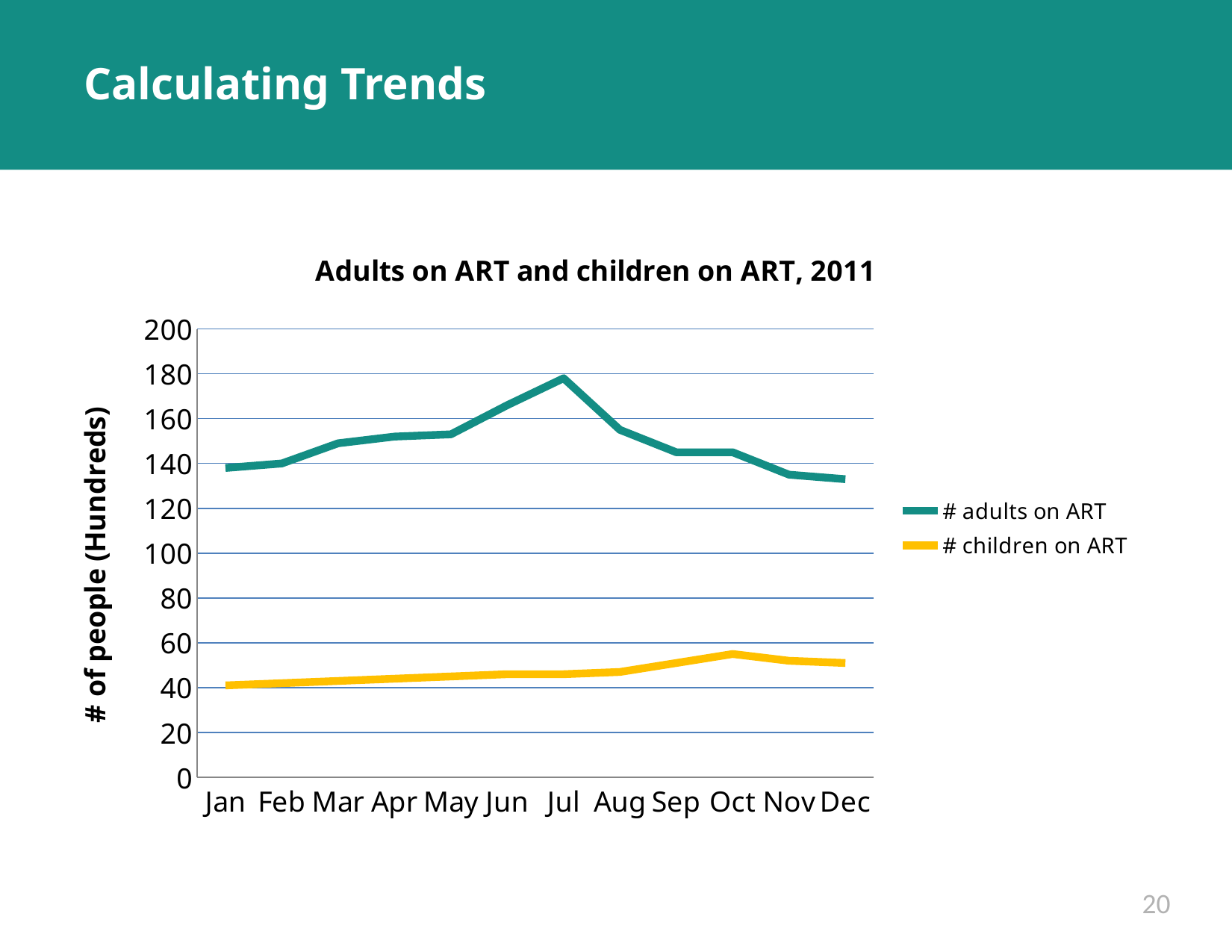
Is the value for # adults on ART in Dec greater or less than 140? less Is the value for # adults on ART in Jul greater or less than 160? greater What is the title of the chart? Adults on ART and children on ART, 2011 Does the number of adults on ART rise or fall from Jul to Dec? fall Which is larger, the number of adults on ART in Jul or in Aug? Jul How many months are plotted along the x axis? 12 How many series does the legend list? 2 In which month is the number of children on ART highest? Oct Is the value for # adults on ART in Mar greater or less than 140? greater What kind of chart is shown on the slide? line chart In which month is the number of adults on ART highest? Jul